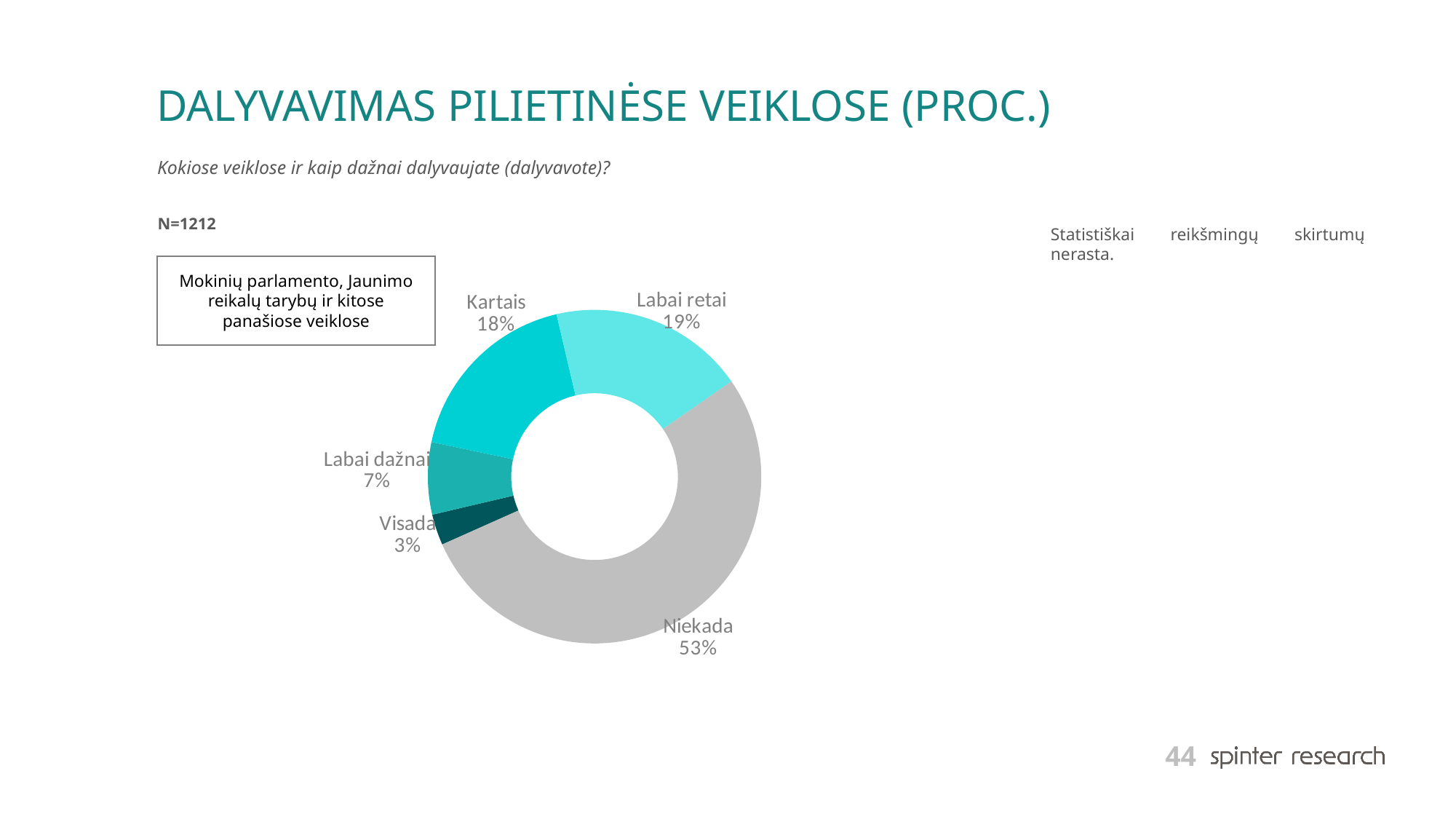
What is the sample size (N) stated on the slide? N=1212 What percentage of respondents answered "Niekada"? 53% Which category has the smallest share of the pie? Visada What is the difference in percentage points between "Niekada" and "Labai retai"? 34 Which category has the largest share of the pie? Niekada Which is larger, the share for "Labai dažnai" or the share for "Visada"? Labai dažnai What kind of chart is shown on the slide? Pie chart (doughnut) What percentage of respondents answered "Kartais"? 18% What percentage of respondents answered "Visada"? 3% What percentage of respondents answered "Labai dažnai"? 7% How many categories are shown in the chart? 5 What percentage of respondents answered "Labai retai"? 19%